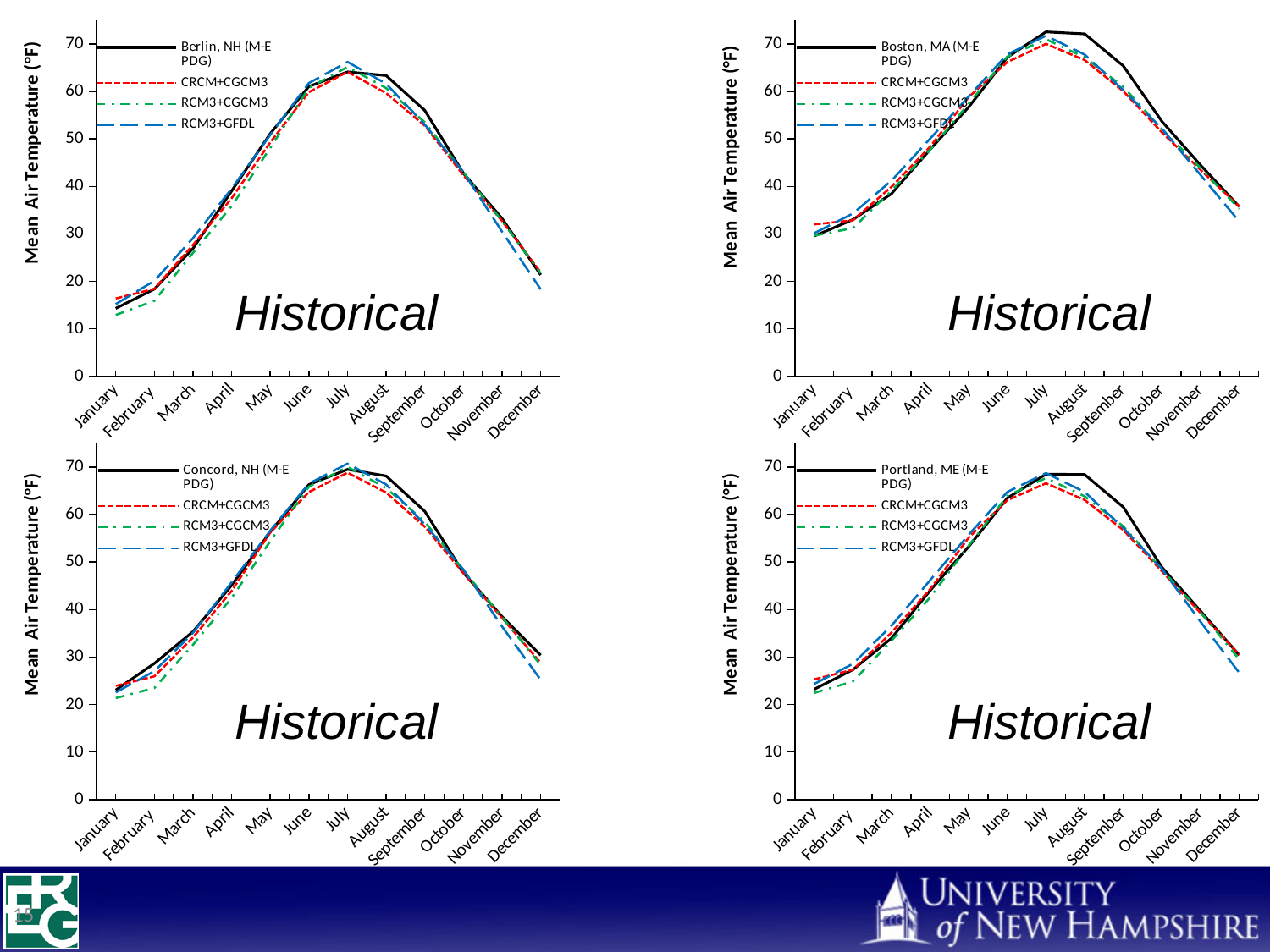
How many series does the legend of the Boston, MA chart list? 4 In the Boston, MA chart, which month has the lowest Boston, MA (M-E PDG) value? January Which is larger: the July value of the Boston, MA (M-E PDG) series in the Boston chart or the July value of the Berlin, NH (M-E PDG) series in the Berlin chart? Boston, MA (M-E PDG) In the Concord, NH chart, is the Concord, NH (M-E PDG) value for January greater or less than 30? less In the Berlin, NH chart, which month has the lowest Berlin, NH (M-E PDG) value? January In the Portland, ME chart, do the Portland, ME (M-E PDG) values rise or fall from January to July? rise How many months are shown on the x axis of the Concord, NH chart? 12 In the Boston, MA chart, is the Boston, MA (M-E PDG) value for July greater or less than 70? greater What kind of chart is the Berlin, NH chart in the top-left? line chart In the Berlin, NH chart, is the Berlin, NH (M-E PDG) value for July greater or less than 60? greater What is the y-axis label on the Concord, NH chart? Mean Air Temperature (°F)